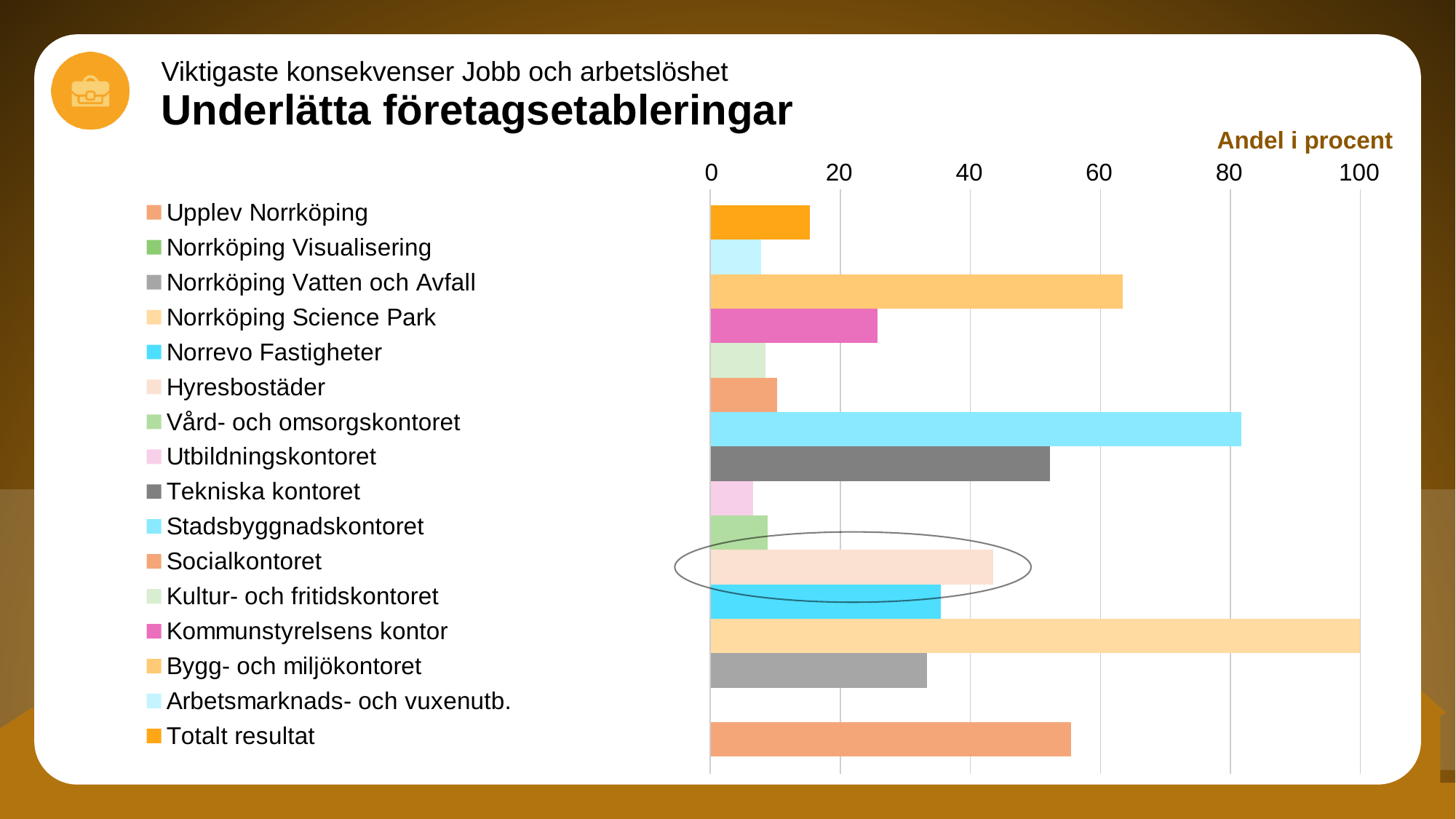
Is the value for Upplev Norrköping greater or less than 60? less Is the value for Tekniska kontoret greater or less than 40? greater What is the value for Norrköping Science Park? 100 What label is shown above the chart's horizontal axis? Andel i procent Is the value for Norrevo Fastigheter greater or less than 40? less Which is larger, the value for Stadsbyggnadskontoret or the value for Tekniska kontoret? Stadsbyggnadskontoret What kind of chart is shown on the slide? bar chart How many categories does the chart legend list? 16 Which category has the highest value in the chart? Norrköping Science Park Which is larger, the value for Bygg- och miljökontoret or the value for Kommunstyrelsens kontor? Bygg- och miljökontoret